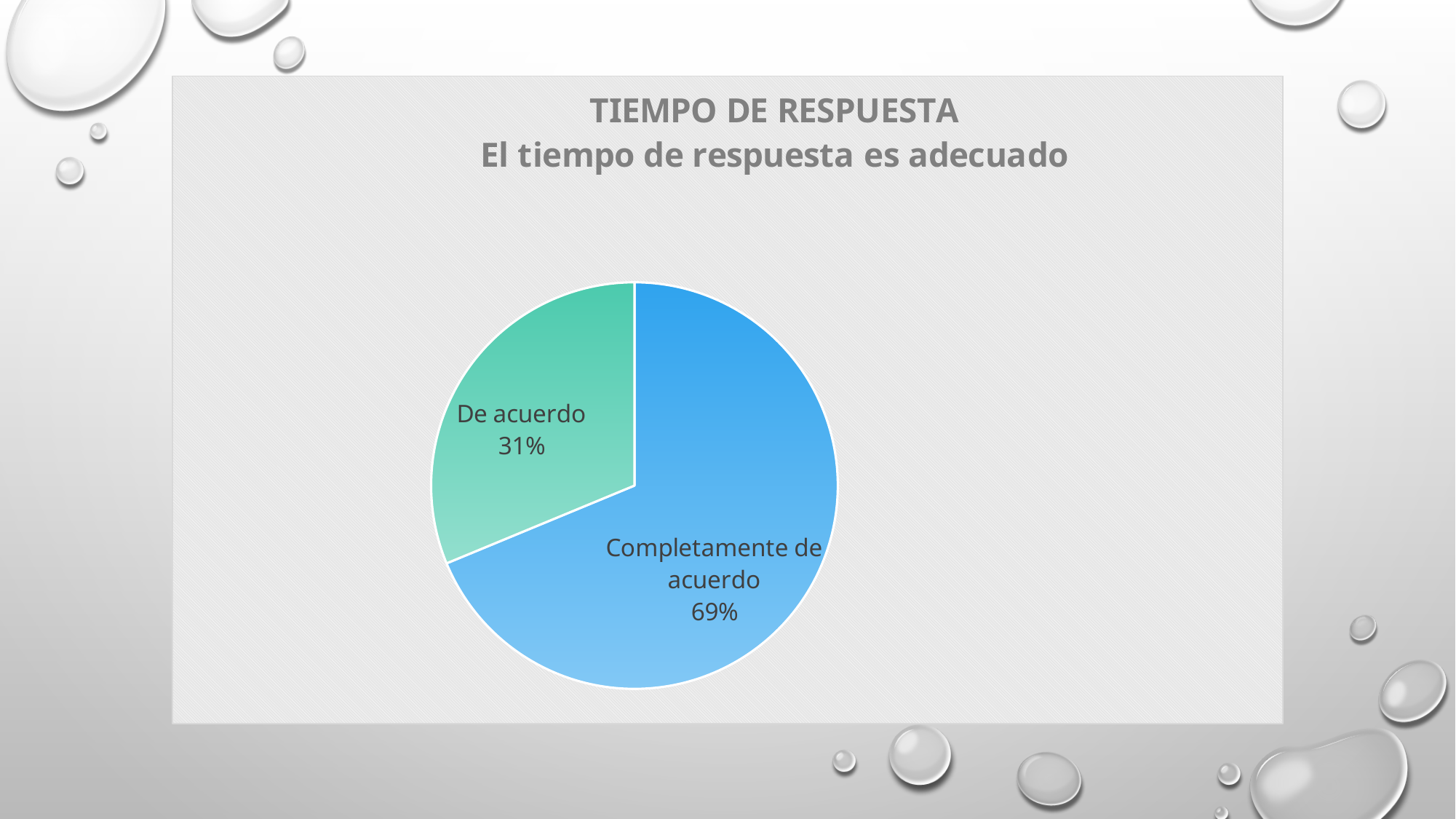
What colour is the "De acuerdo" slice? Green What kind of chart is shown on the slide? Pie chart How many slices does the pie chart have? 2 Which slice is the smallest? De acuerdo Which slice is the largest? Completamente de acuerdo What is the difference in percentage points between "Completamente de acuerdo" and "De acuerdo"? 38 Which is larger, the share for "De acuerdo" or the share for "Completamente de acuerdo"? Completamente de acuerdo What is the title of the chart? TIEMPO DE RESPUESTA El tiempo de respuesta es adecuado What share of the pie does "Completamente de acuerdo" represent? 69% What share of the pie does "De acuerdo" represent? 31%